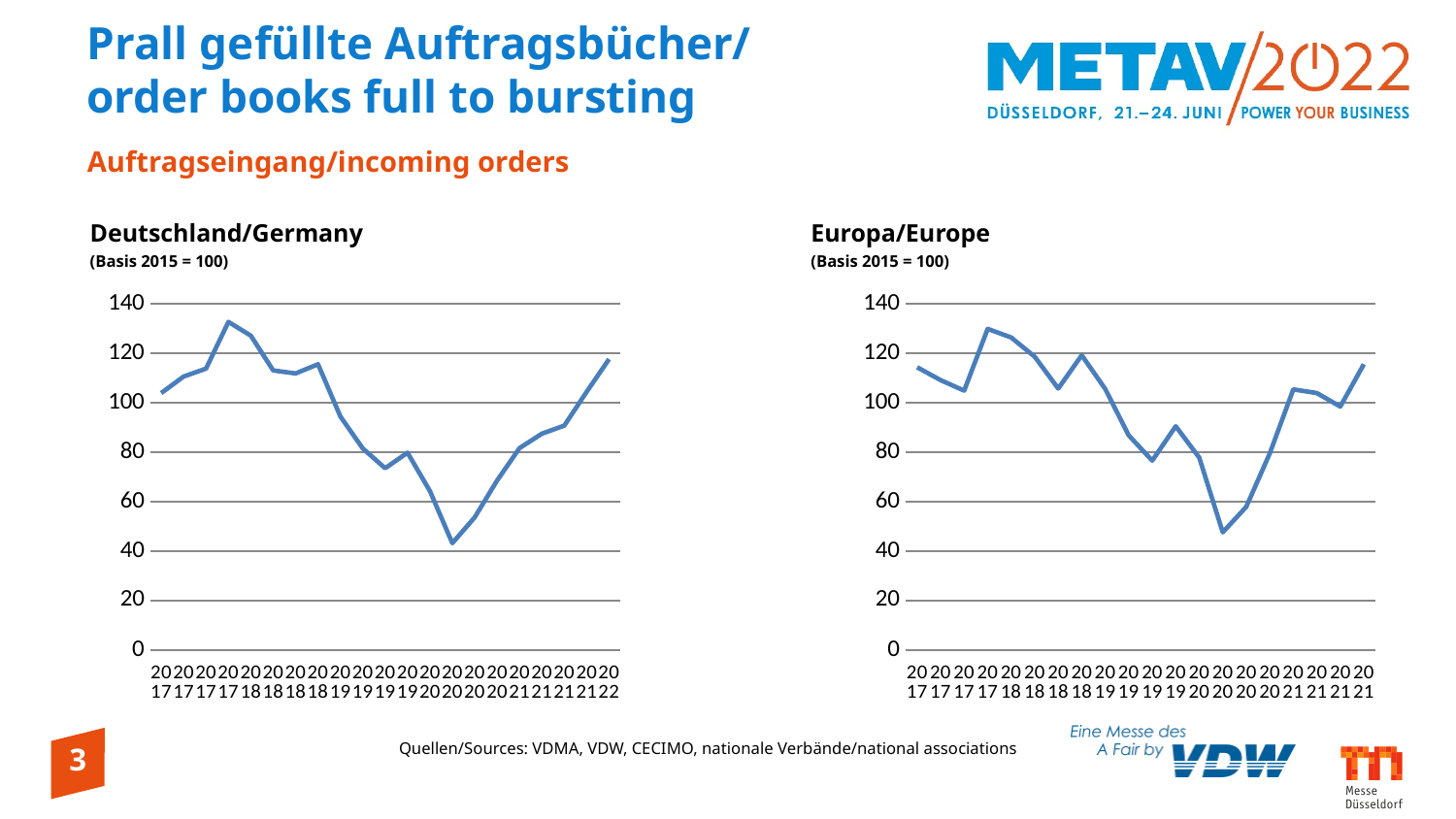
On the Deutschland/Germany chart, is the lowest point of the line greater or less than 60? less On the Europa/Europe chart, in which year does the line reach its lowest point? 2020 What base year is stated in the subtitle of both charts? Basis 2015 = 100 What kind of chart is the Europa/Europe chart? line chart On the Europa/Europe chart, is the last plotted value (2021) greater or less than 100? greater On the Deutschland/Germany chart, is the highest point of the line greater or less than 120? greater On the Deutschland/Germany chart, does the line rise or fall from its 2020 low to the 2022 value? rise How many data points are plotted on the Deutschland/Germany chart? 21 What kind of chart is the Deutschland/Germany chart? line chart On the Deutschland/Germany chart, in which year does the line reach its lowest point? 2020 How many data points are plotted on the Europa/Europe chart? 20